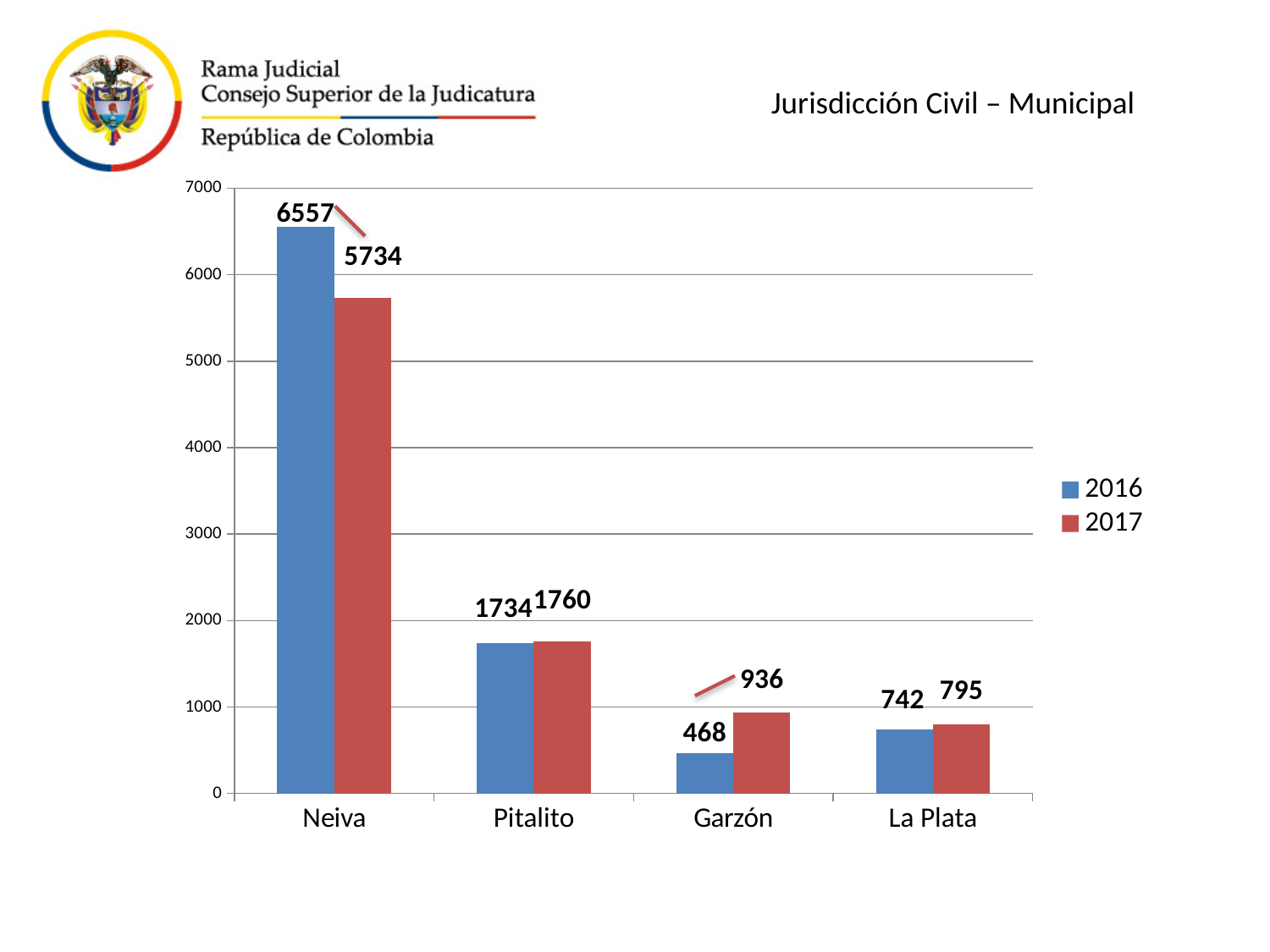
How many series does the legend list? 2 What kind of chart is shown on the slide? bar chart Which category has the lowest value in 2016? Garzón What is the value for La Plata in 2016? 742 What is the value for Neiva in 2016? 6557 Which is larger for Pitalito, the 2016 value or the 2017 value? 2017 Which category has the highest value in 2017? Neiva What is the value for Garzón in 2017? 936 Is the 2017 value for Neiva greater or less than 6000? less How many categories are shown on the x axis? 4 What is the difference between the 2017 and 2016 values for Garzón? 468 What is the difference between the 2016 and 2017 values for Neiva? 823